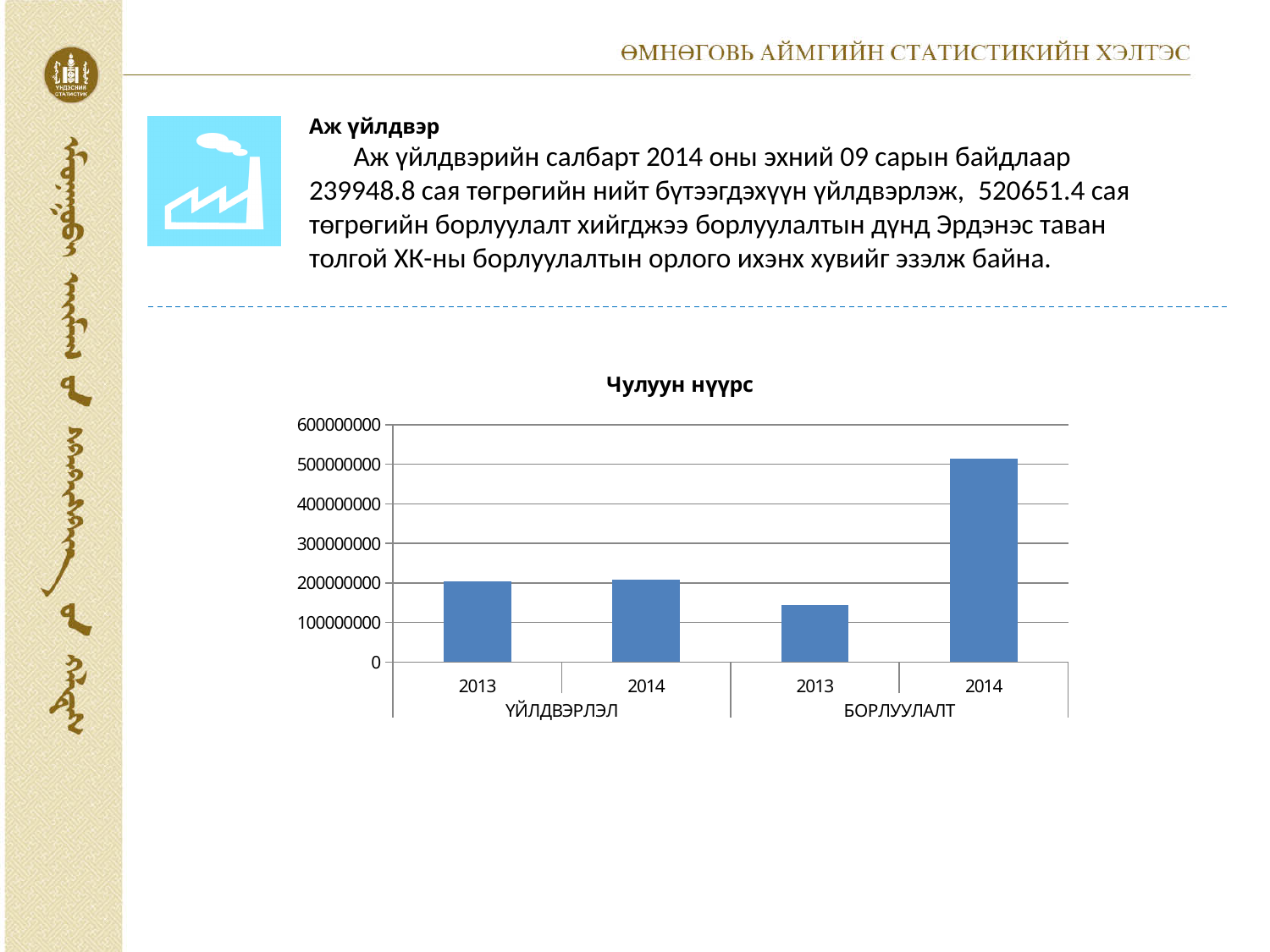
How many bars are plotted in the chart? 4 Is the value for БОРЛУУЛАЛТ 2013 greater or less than 200000000? less Is the value for БОРЛУУЛАЛТ 2014 greater or less than 500000000? greater Which is larger, the value for ҮЙЛДВЭРЛЭЛ 2014 or the value for БОРЛУУЛАЛТ 2013? ҮЙЛДВЭРЛЭЛ 2014 What kind of chart is shown on the slide? bar chart Is the value for ҮЙЛДВЭРЛЭЛ 2014 greater or less than 100000000? greater Within БОРЛУУЛАЛТ, does the value rise or fall from 2013 to 2014? rise Which bar is the highest in the chart? БОРЛУУЛАЛТ 2014 Within БОРЛУУЛАЛТ, which year has the larger value, 2013 or 2014? 2014 Which bar is the lowest in the chart? БОРЛУУЛАЛТ 2013 What is the title of the chart? Чулуун нүүрс